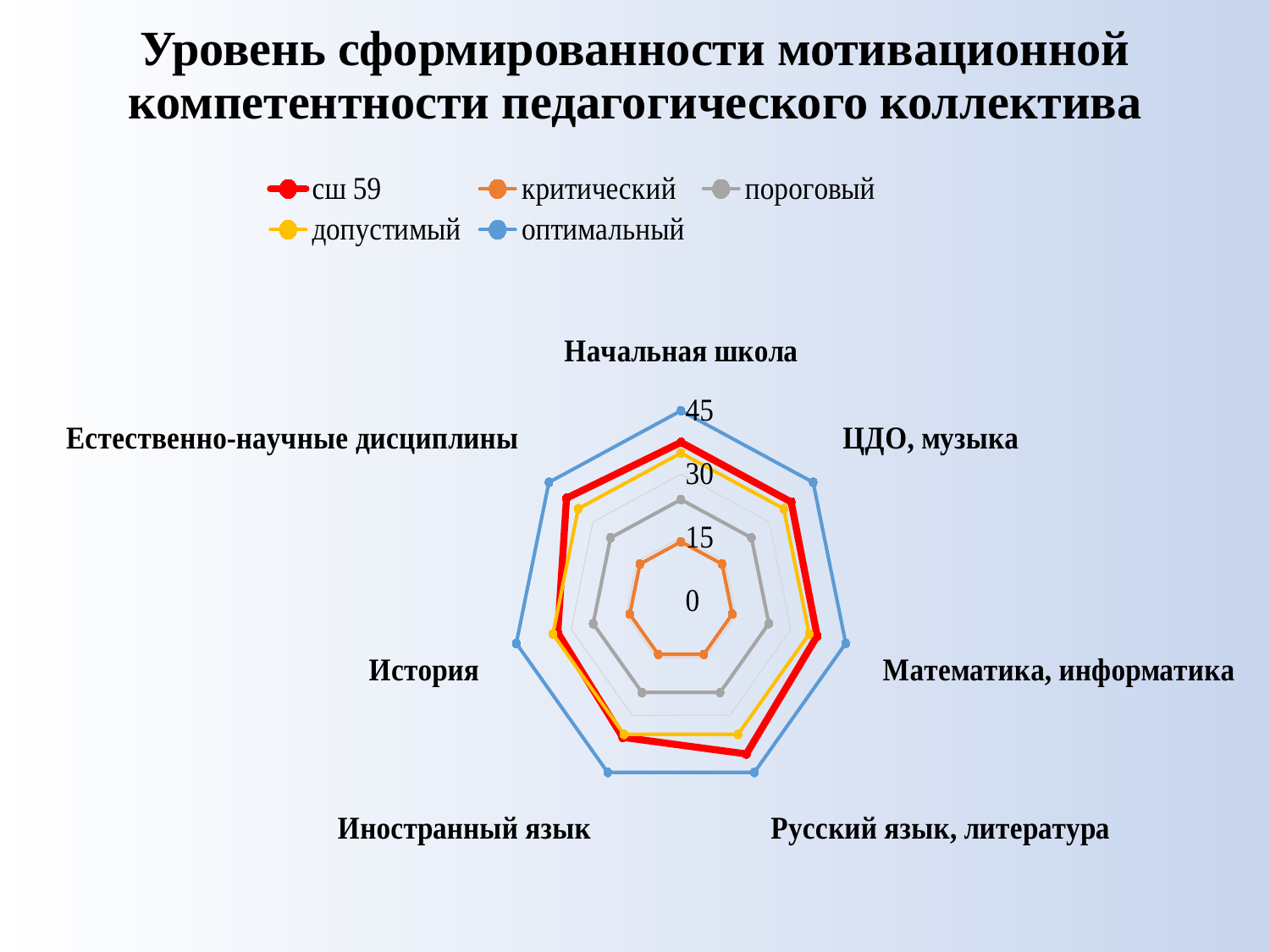
For Математика, информатика, which is larger: сш 59 or критический? сш 59 For История, which is larger: оптимальный or пороговый? оптимальный Is the value of сш 59 for Начальная школа greater or less than 30? greater Which series is drawn in red on the chart? сш 59 Is the value of the пороговый series for История greater or less than 45? less How many series does the legend list? 5 What is the highest value shown on the chart's axis scale? 45 What kind of chart is shown on the slide? radar chart Is the value of сш 59 for Начальная школа greater or less than 45? less How many categories (axes) does the radar chart have? 7 What is the value of the оптимальный series for Начальная школа? 45